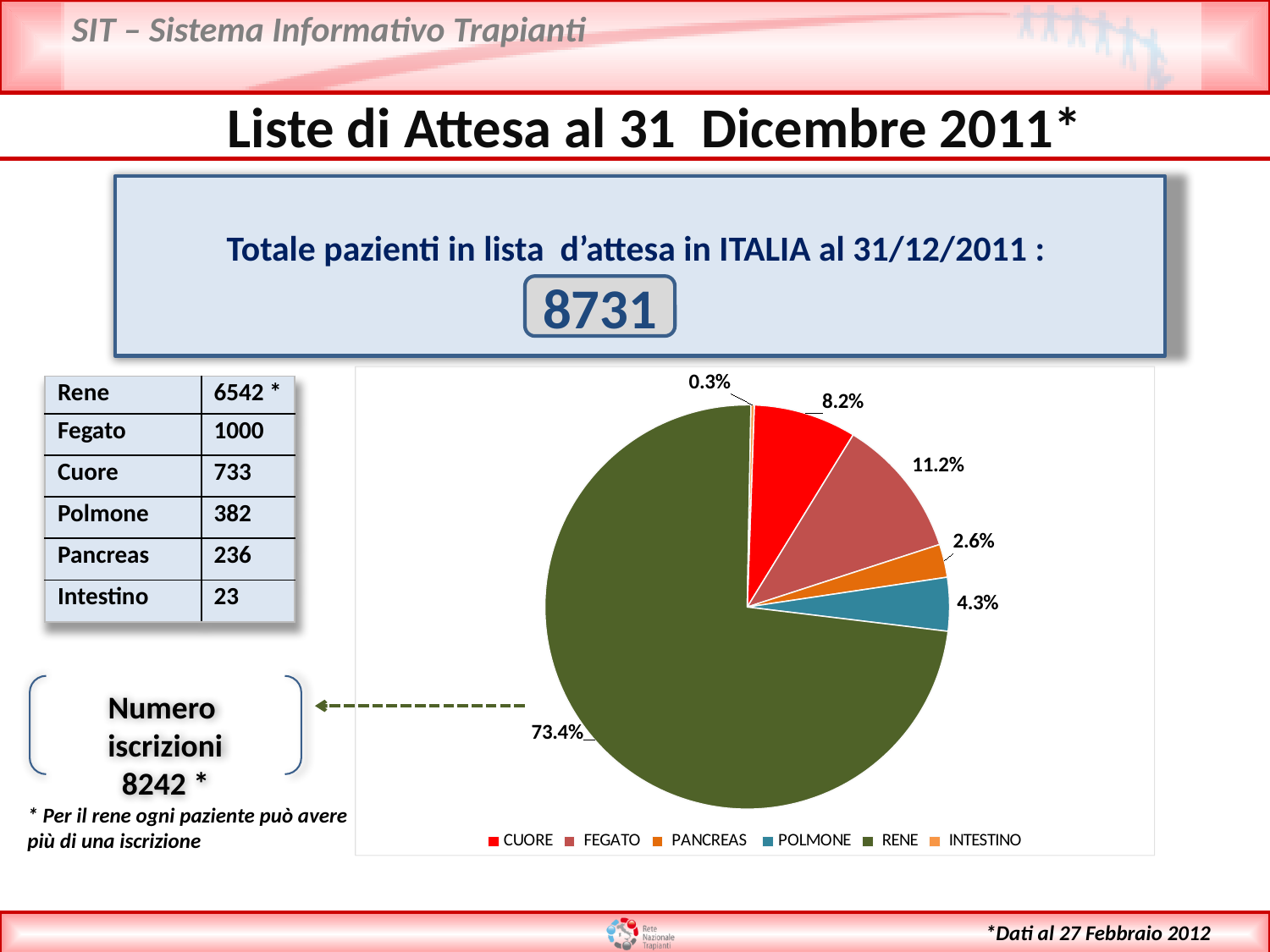
How many categories does the legend of the pie chart list? 6 What share of the pie chart does CUORE represent? 8.2% What share of the pie chart does INTESTINO represent? 0.3% What share of the pie chart does PANCREAS represent? 2.6% Which slice is larger, POLMONE or PANCREAS? POLMONE Which category has the largest slice in the pie chart? RENE What kind of chart is shown on the slide? pie chart What is the difference in percentage points between the FEGATO and CUORE slices? 3.0% Which category has the smallest slice in the pie chart? INTESTINO